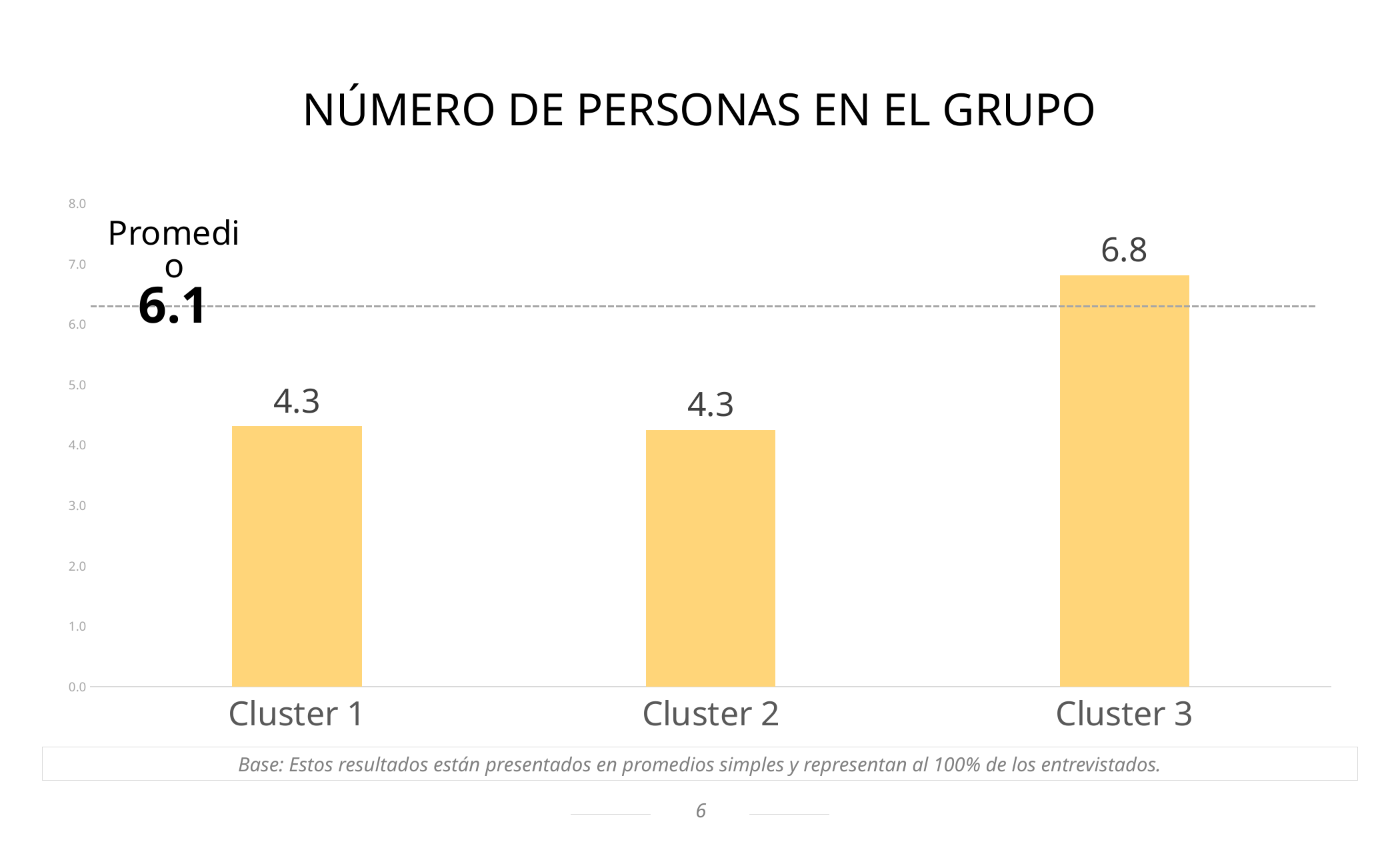
What is the average (Promedio) value indicated by the dashed line? 6.1 Is the value for Cluster 3 greater or less than 6.0? greater Which is larger, the value for Cluster 3 or the value for Cluster 2? Cluster 3 Which cluster has the highest value? Cluster 3 How many clusters are shown in the chart? 3 Is the value for Cluster 1 greater or less than 5.0? less What is the difference between the values for Cluster 3 and Cluster 1? 2.5 What is the value for Cluster 2? 4.3 What kind of chart is shown on the slide? bar chart What is the title of the chart? NÚMERO DE PERSONAS EN EL GRUPO What is the value for Cluster 3? 6.8 What is the value for Cluster 1? 4.3